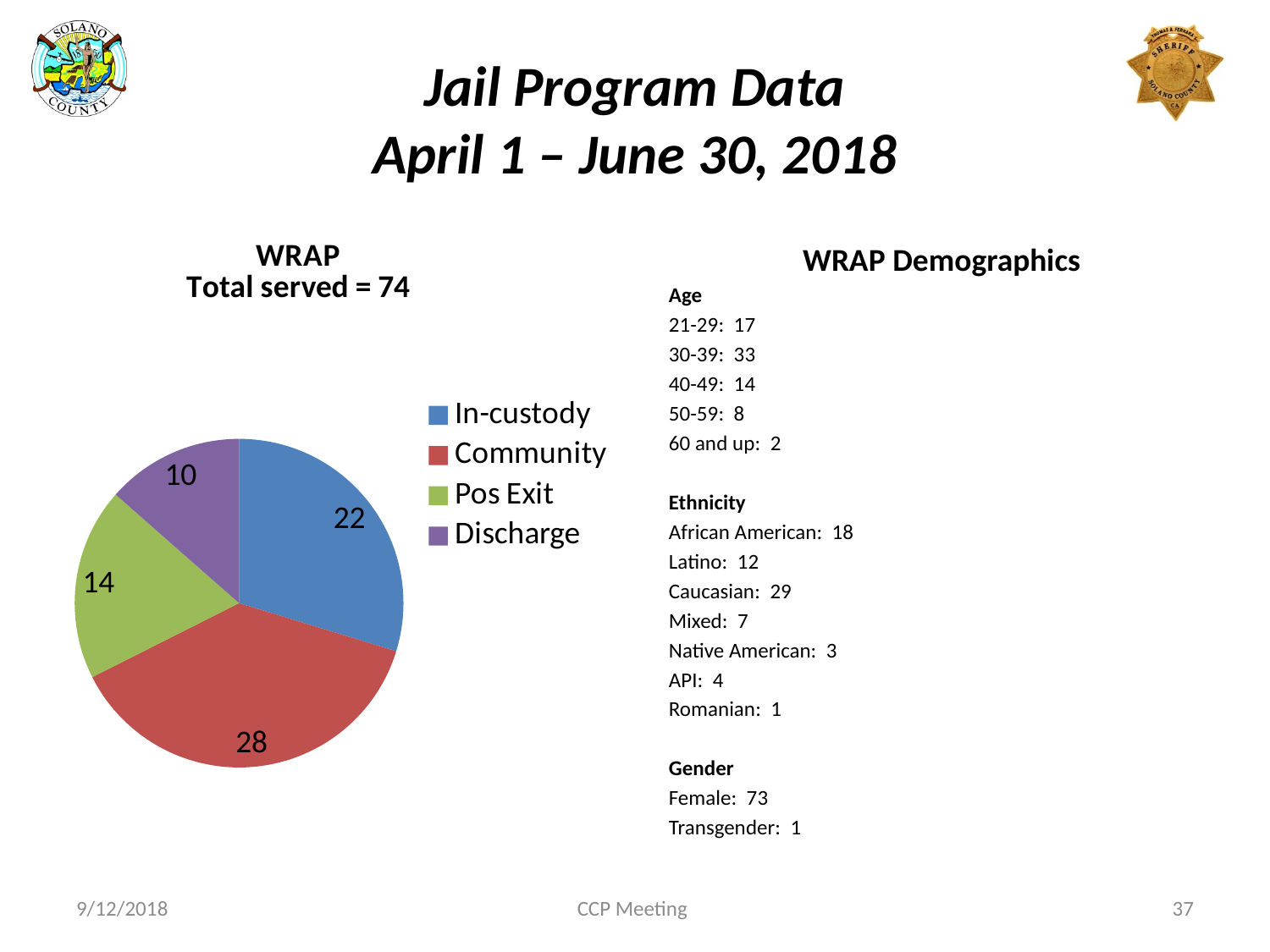
What is the value for In-custody in the WRAP pie chart? 22 What is the value for Pos Exit in the WRAP pie chart? 14 What is the value for Discharge in the WRAP pie chart? 10 Which category has the largest slice in the WRAP pie chart? Community What is the total served shown in the WRAP chart title? 74 What is the difference between the Community and In-custody values in the WRAP pie chart? 6 How many categories does the WRAP pie chart show? 4 What kind of chart is shown on the slide? pie chart Which category has the smallest slice in the WRAP pie chart? Discharge What colour is the Community slice in the WRAP pie chart? red Which is larger in the WRAP pie chart, Pos Exit or Discharge? Pos Exit What is the value for Community in the WRAP pie chart? 28